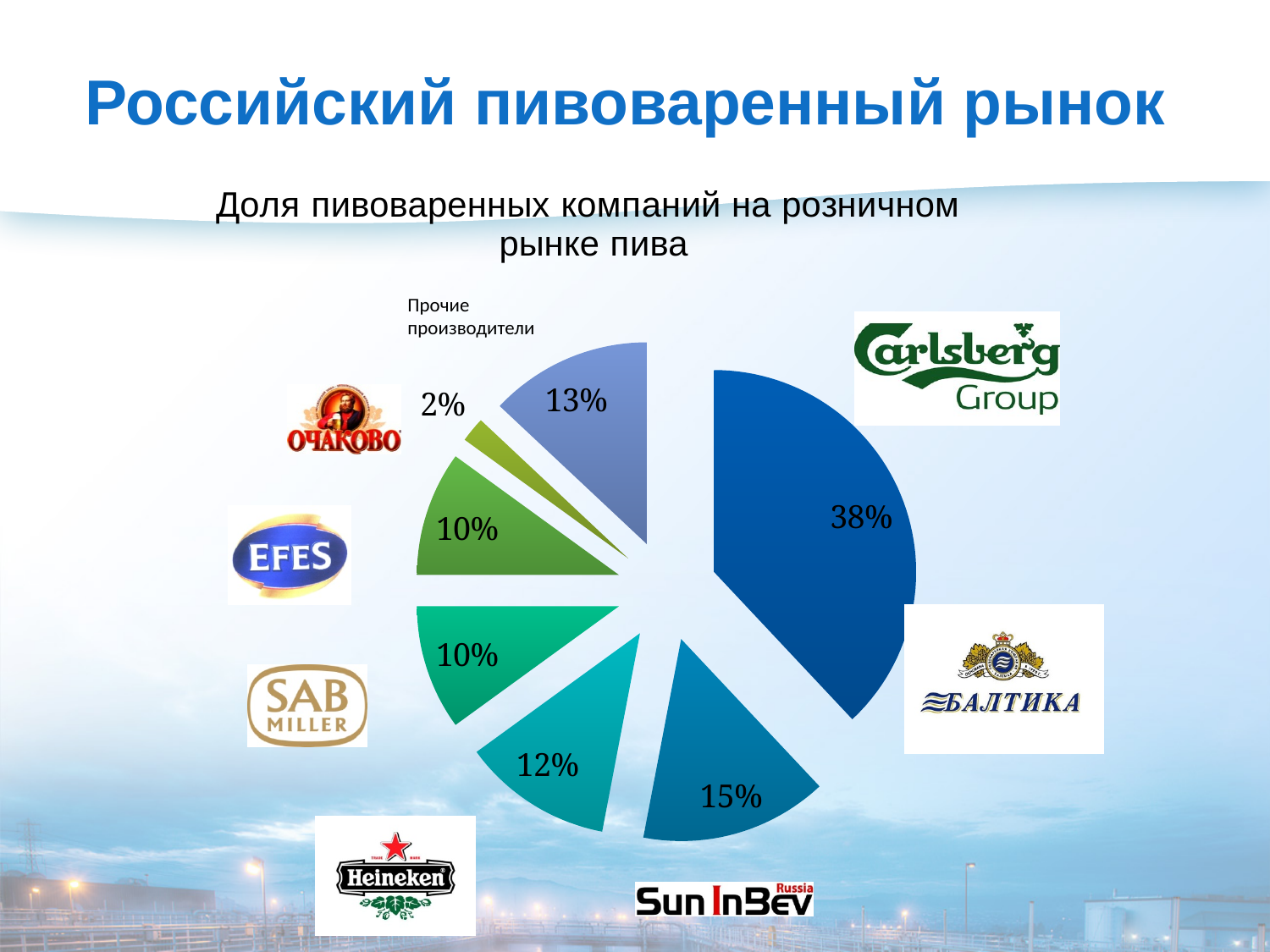
How many slices does the pie chart have? 7 What share of the pie is labelled next to the Carlsberg Group / Балтика logos? 38% What share of the pie is labelled next to the Sun InBev logo? 15% What share of the pie is labelled next to the Очаково logo? 2% What is the title of the chart? Доля пивоваренных компаний на розничном рынке пива Which is larger: the Heineken slice or the 'Прочие производители' slice? Прочие производители (13%) Which slice of the pie is the smallest? 2% (Очаково) What share of the pie is labelled for 'Прочие производители'? 13% What kind of chart is shown on the slide? pie chart Which slice of the pie is the largest? 38% (Carlsberg Group / Балтика) What share of the pie is labelled next to the Heineken logo? 12% What is the difference between the largest slice (38%) and the Sun InBev slice (15%)? 23%